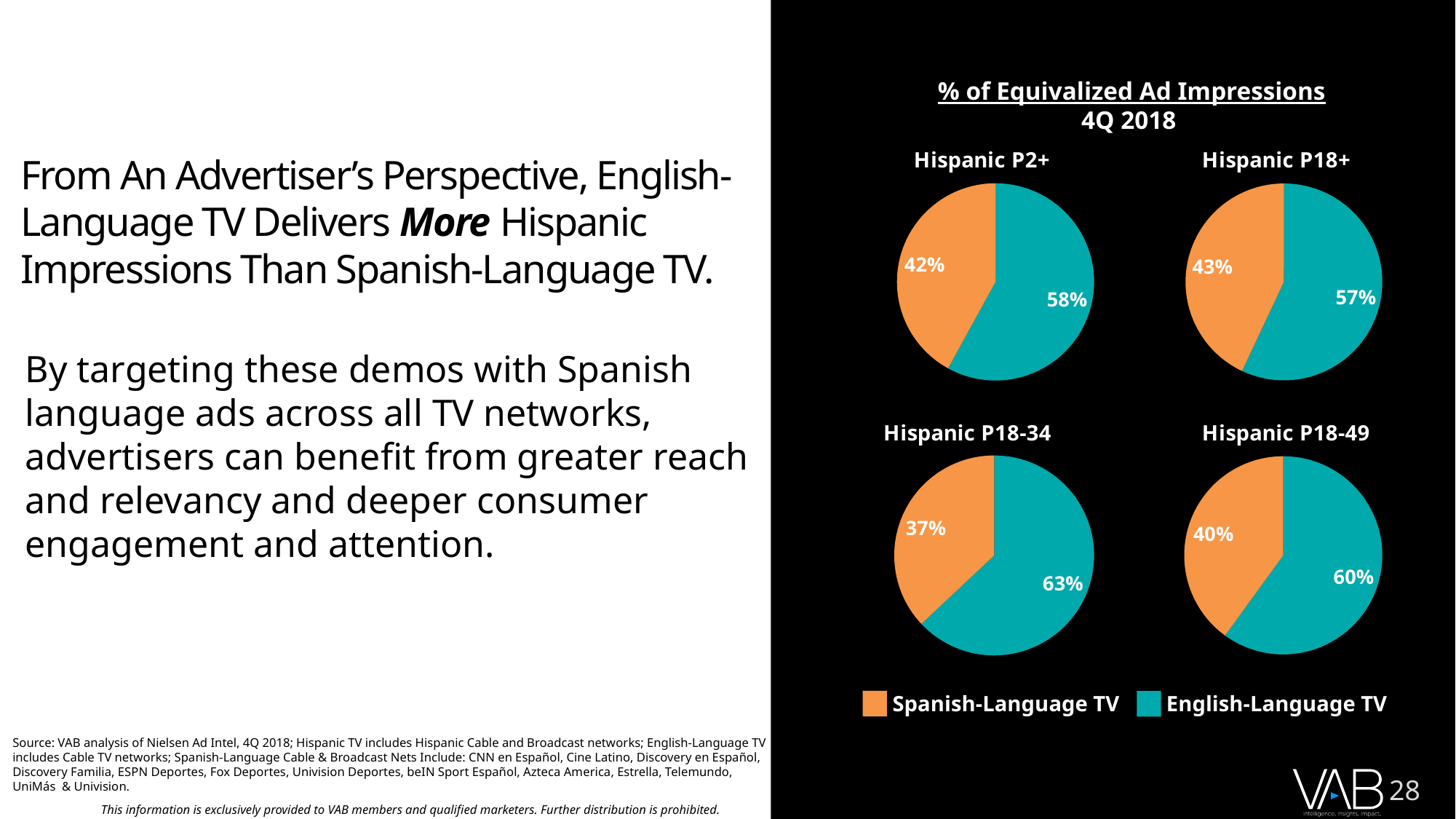
In the Hispanic P18+ pie chart, what share of equivalized ad impressions does Spanish-Language TV have? 43% How many pie charts are shown on the slide? 4 What type of chart is used to show the % of Equivalized Ad Impressions? Pie chart In the Hispanic P2+ pie chart, what share of equivalized ad impressions does English-Language TV have? 58% In the Hispanic P2+ pie chart, which is larger: the Spanish-Language TV share or the English-Language TV share? English-Language TV How many series does the legend list for the pie charts? 2 In the Hispanic P18-49 pie chart, what share does Spanish-Language TV have? 40% Across the four pie charts, which demo has the highest English-Language TV share? Hispanic P18-34 In the Hispanic P18-49 pie chart, what is the difference between the English-Language TV share and the Spanish-Language TV share? 20% Which colour represents Spanish-Language TV in the pie charts? Orange Across the four pie charts, which demo has the lowest Spanish-Language TV share? Hispanic P18-34 In the Hispanic P18-34 pie chart, what share does English-Language TV have? 63%